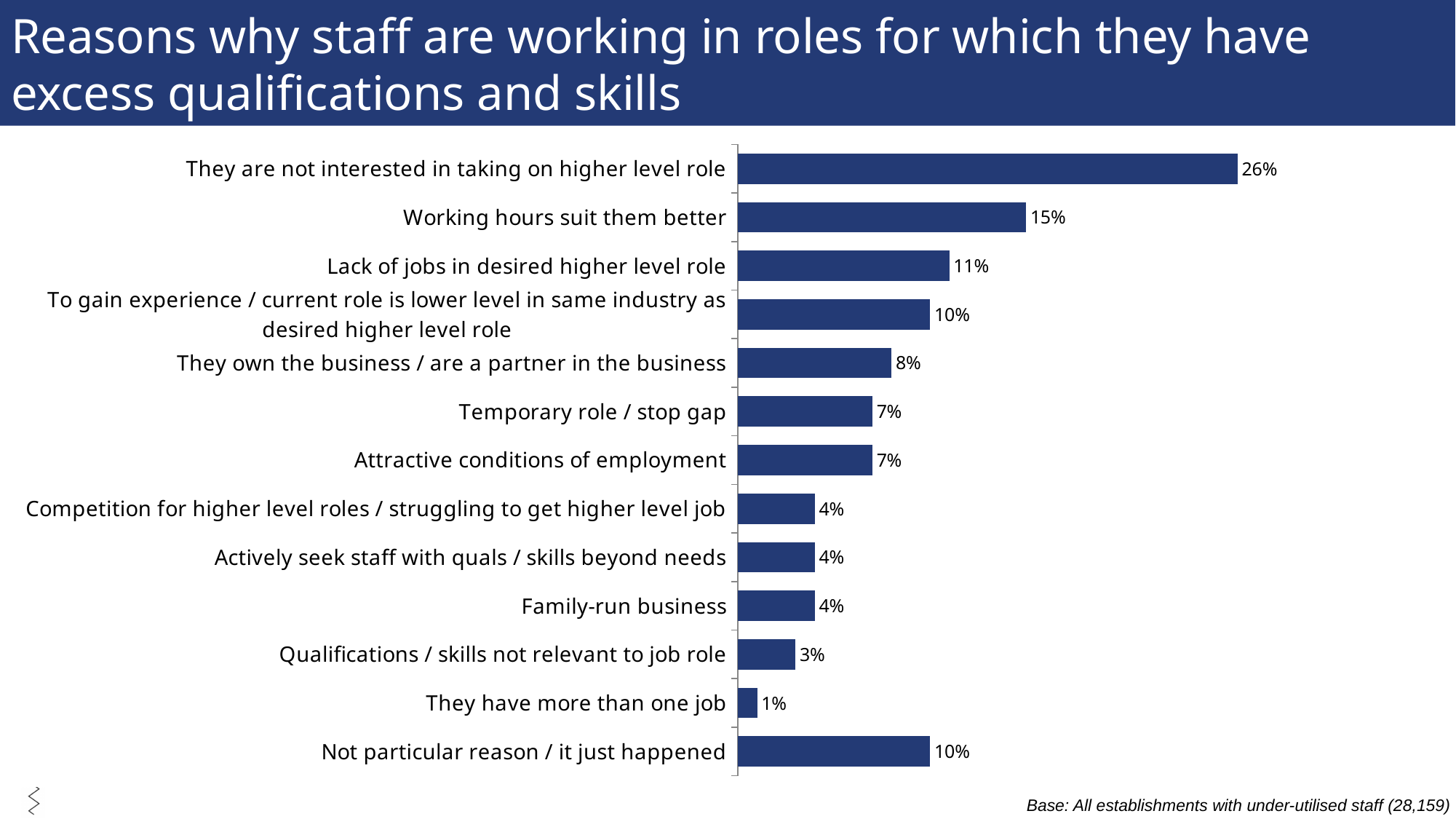
Which is larger: 'Lack of jobs in desired higher level role' or 'Temporary role / stop gap'? Lack of jobs in desired higher level role What percentage is shown for 'They are not interested in taking on higher level role'? 26% What is the value for 'Working hours suit them better'? 15% Which reason has the highest percentage? They are not interested in taking on higher level role Which reason has the lowest percentage? They have more than one job What kind of chart is shown on the slide? Bar chart What is the value for 'Not particular reason / it just happened'? 10% What is the value for 'They have more than one job'? 1% What is the difference between 'They are not interested in taking on higher level role' and 'Working hours suit them better'? 11 percentage points What percentage is shown for 'They own the business / are a partner in the business'? 8% What base is stated for the chart? All establishments with under-utilised staff (28,159) How many reasons (categories) are plotted in the chart? 13